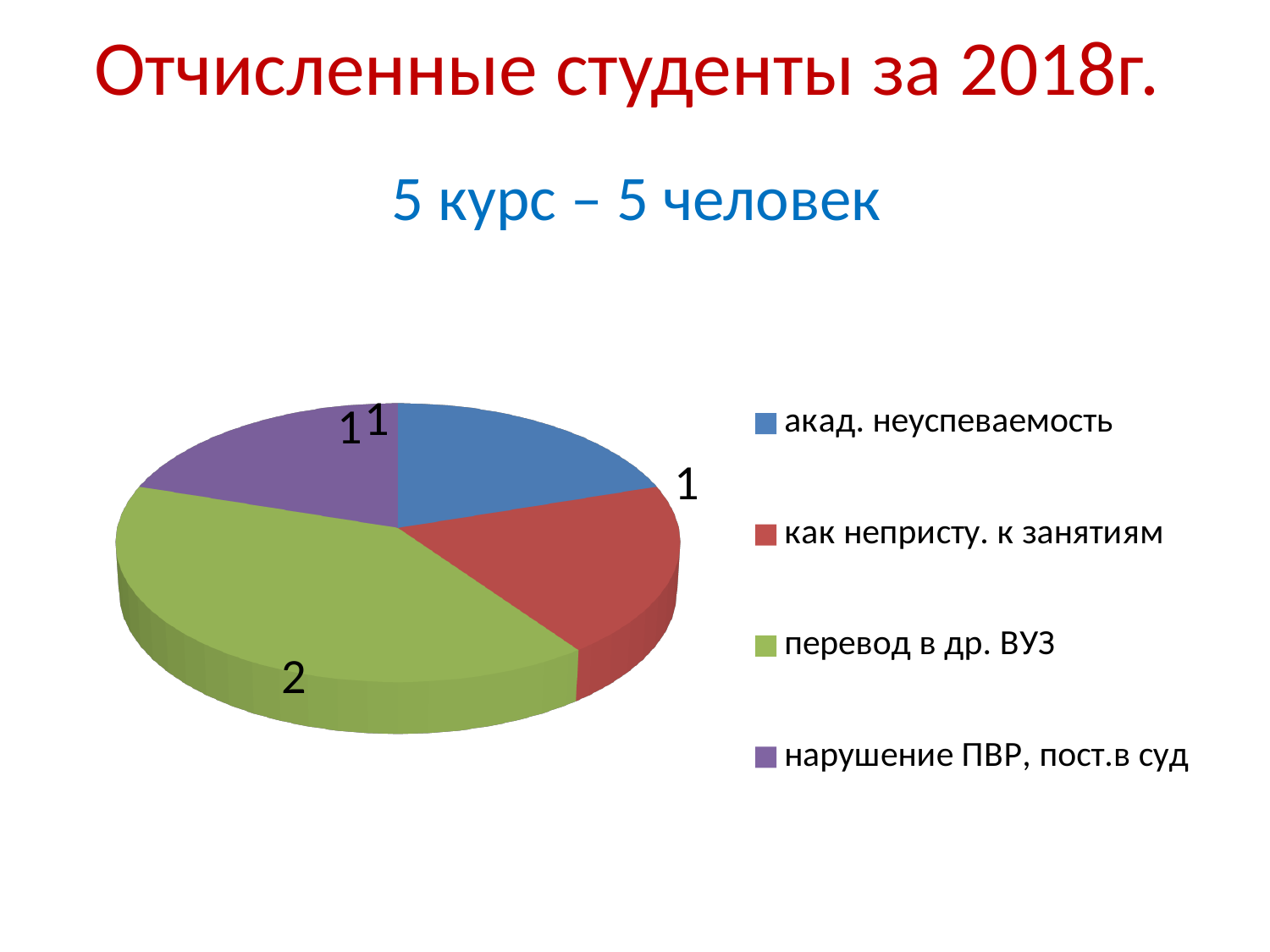
What is the value for акад. неуспеваемость? 1 How many slices does the pie chart have? 4 What colour is the slice for перевод в др. ВУЗ? green How many entries does the legend list? 4 What share of the pie does перевод в др. ВУЗ represent? 40% Which is larger, the value for перевод в др. ВУЗ or the value for как непристу. к занятиям? перевод в др. ВУЗ What is the value for нарушение ПВР, пост.в суд? 1 What is the value for как непристу. к занятиям? 1 What is the difference between the value for перевод в др. ВУЗ and the value for акад. неуспеваемость? 1 What type of chart is shown on the slide? pie chart Which category has the largest slice? перевод в др. ВУЗ What is the value for перевод в др. ВУЗ? 2